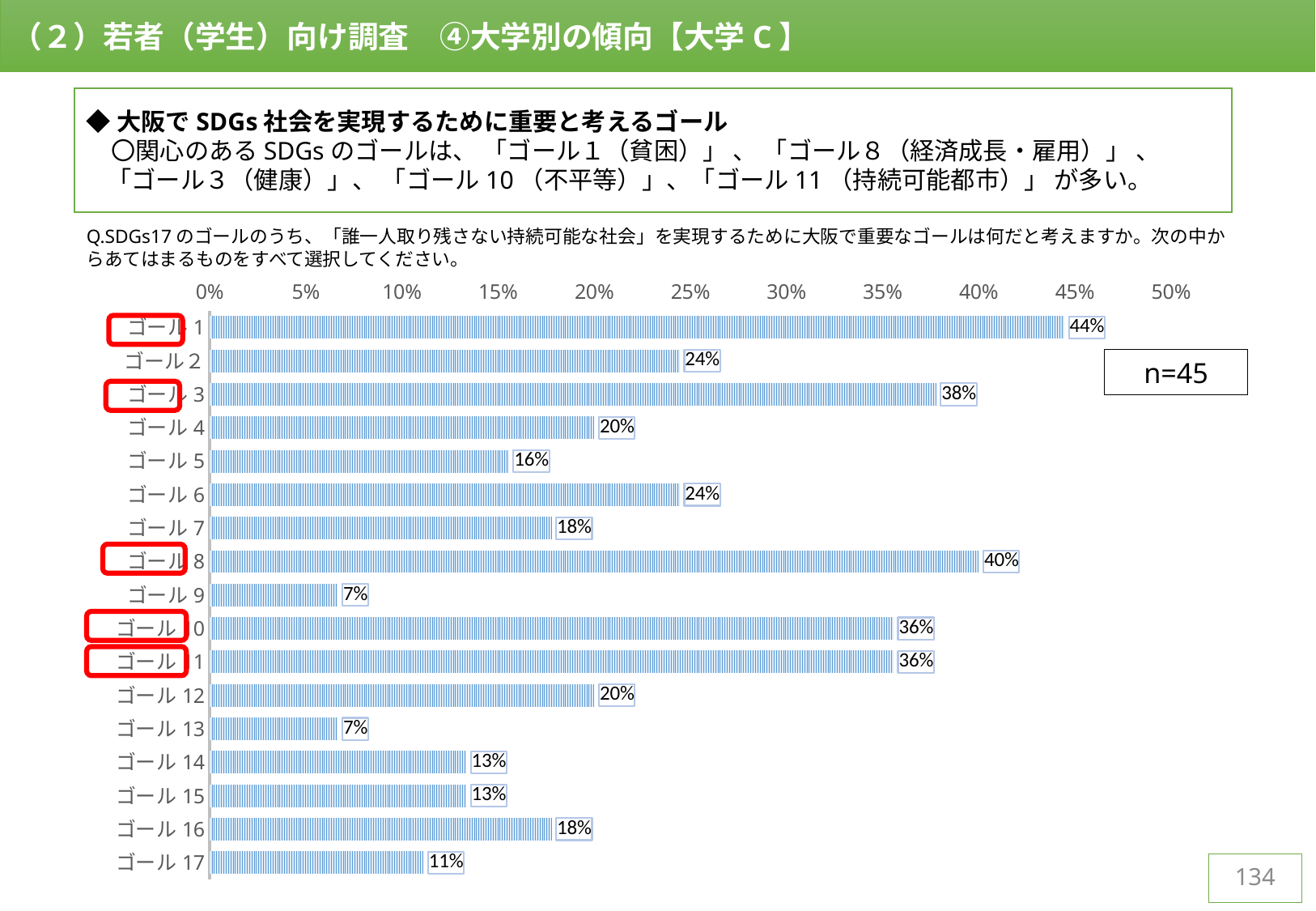
What is the difference between the values for ゴール3 and ゴール5? 22% What is the value for ゴール1? 44% What kind of chart is shown on the slide? bar chart What is the sample size (n) shown next to the chart? n=45 Is the value for ゴール9 greater or less than 10%? less What is the difference between the values for ゴール1 and ゴール8? 4% What is the value for ゴール8? 40% What is the value for ゴール3? 38% How many goals (categories) are shown in the chart? 17 Which goal has the highest value? ゴール1 What is the value for ゴール17? 11% Which is larger, the value for ゴール2 or the value for ゴール4? ゴール2